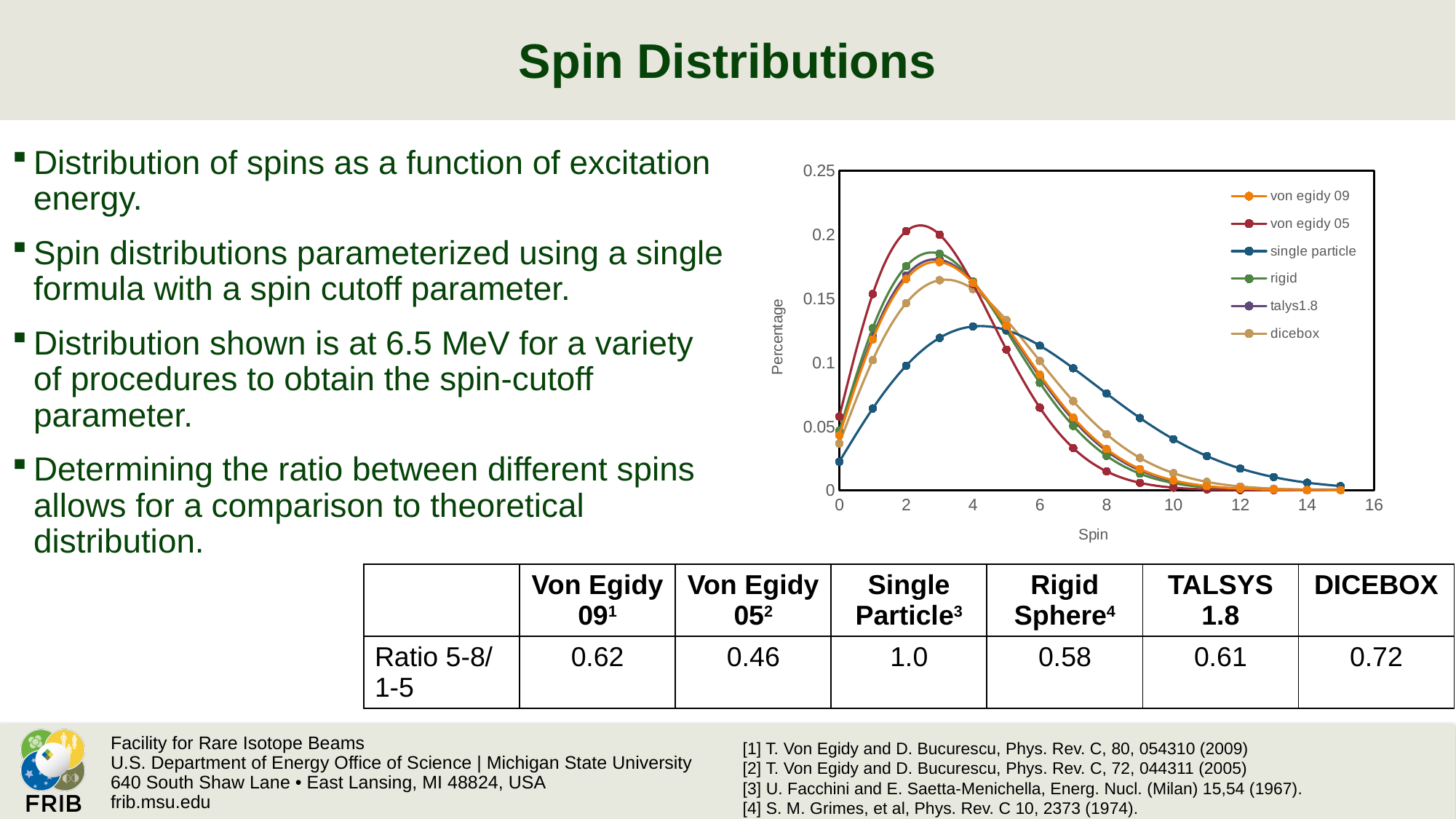
Is the value of the single particle series at spin 0 greater or less than 0.05? less At spin 10, which series has the larger value: single particle or von egidy 05? single particle What kind of chart is shown on the slide? line chart What is the title of the x axis of the chart? Spin Which series reaches the highest peak value on the chart? von egidy 05 Is the value of the von egidy 05 series at spin 8 greater or less than 0.05? less At spin 2, which series has the larger value: von egidy 05 or dicebox? von egidy 05 How many series does the chart legend list? 6 Which series has the lowest peak value on the chart? single particle Does the single particle series rise or fall as spin increases from 4 to 15? fall Is the value of the single particle series at spin 4 greater or less than 0.1? greater What is the title of the y axis of the chart? Percentage